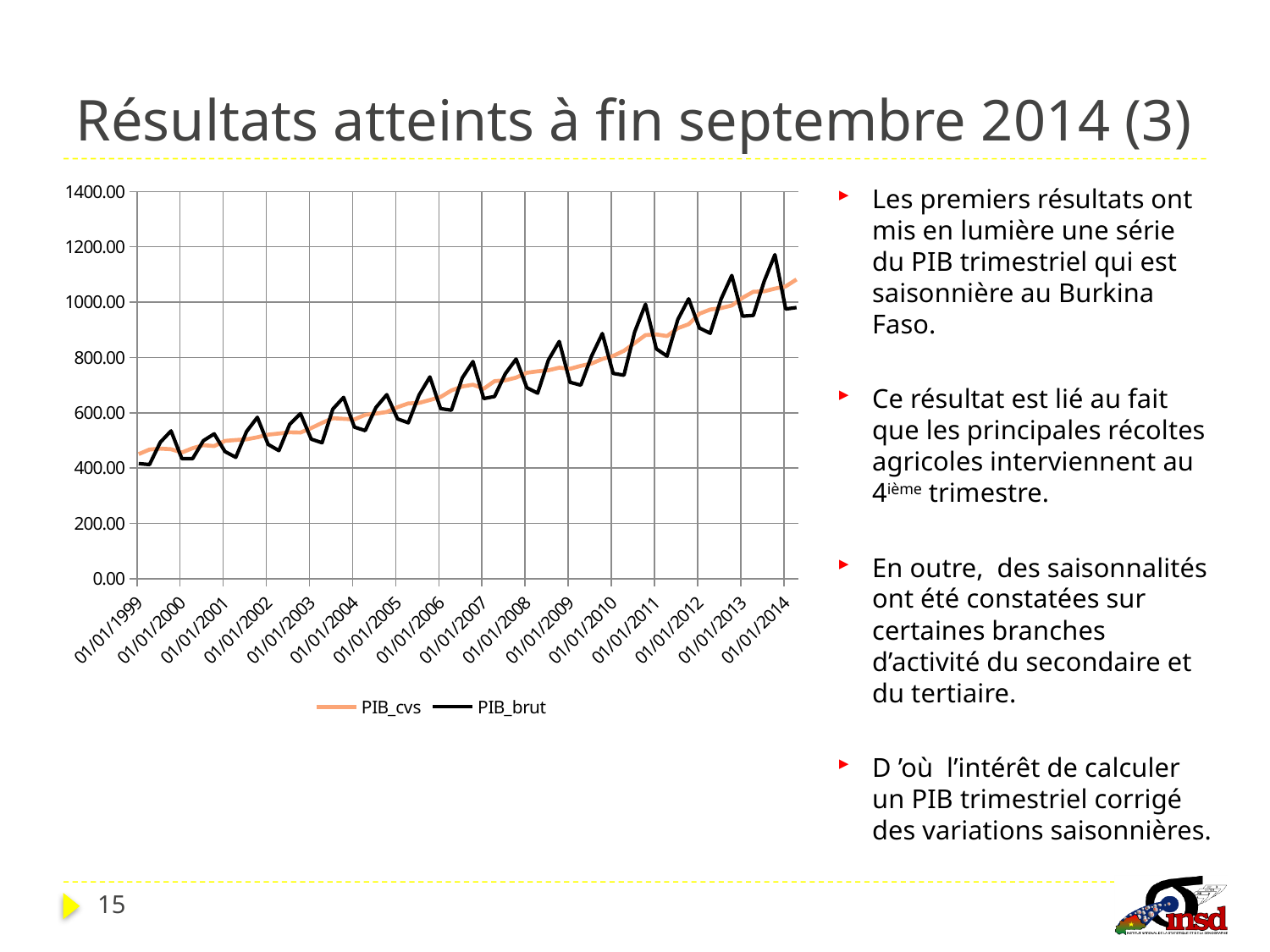
Is the value of PIB_cvs at 01/01/2012 greater or less than 800.00? greater Which series is drawn in black in the chart? PIB_brut How many series does the chart legend list? 2 Is the value of PIB_cvs at 01/01/2014 greater or less than 1000.00? greater What are the names of the two series in the chart legend? PIB_cvs and PIB_brut How many date labels are shown on the x axis of the chart? 16 Do the values of PIB_cvs generally rise or fall from 01/01/1999 to 01/01/2014? Rise What is the highest value shown on the y axis of the chart? 1400.00 Is the value of PIB_cvs at 01/01/1999 greater or less than 600.00? less Which series shows strong seasonal fluctuations, PIB_cvs or PIB_brut? PIB_brut What type of chart is shown on the slide? Line chart